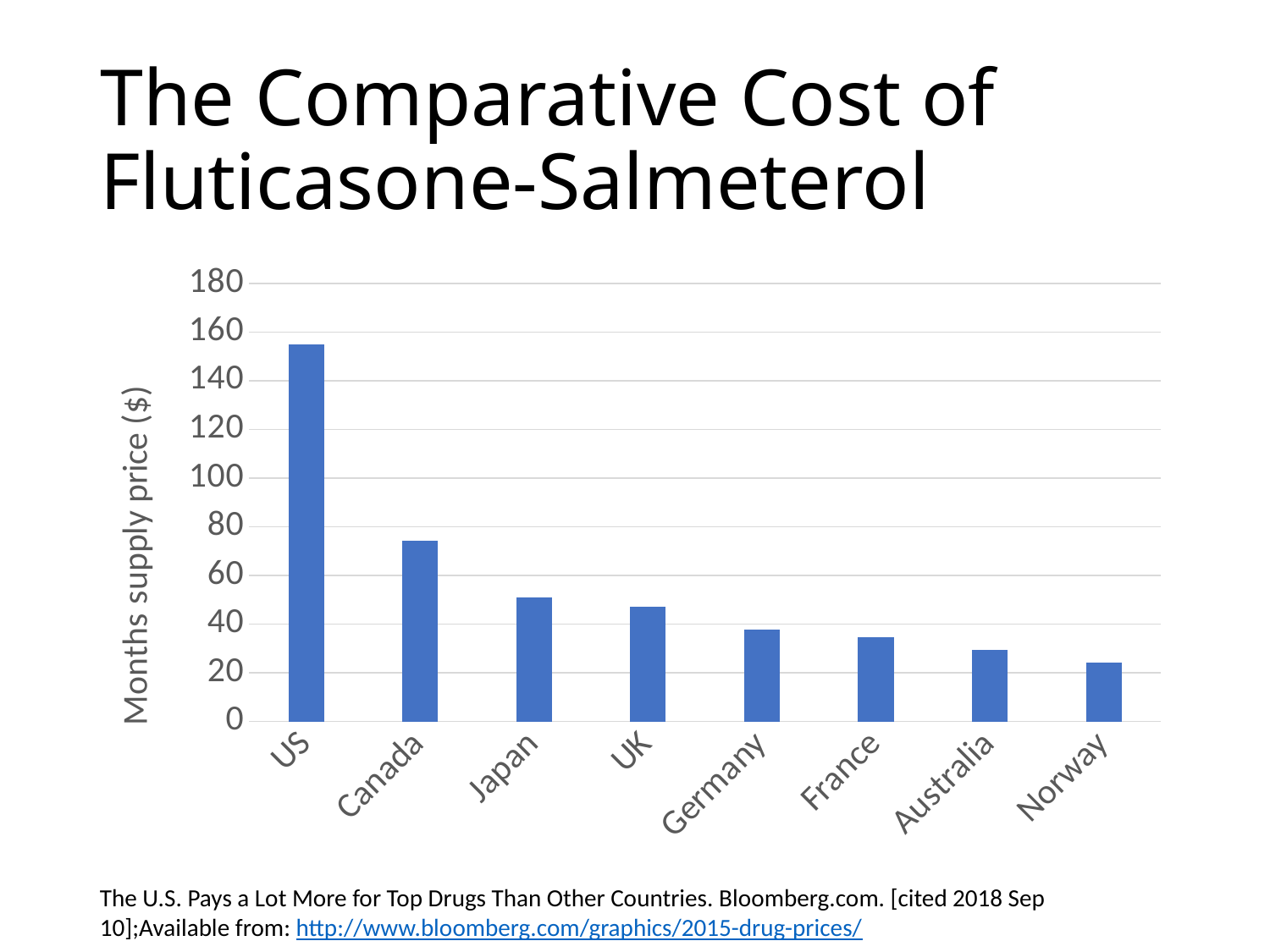
What is the label on the vertical axis of the chart? Months supply price ($) Is the value for US greater or less than 140? greater Which country has the highest months supply price? US Is the value for UK greater or less than 60? less Is the value for Norway greater or less than 40? less Which has a higher months supply price, Canada or Japan? Canada How many countries are shown on the x axis of the chart? 8 Do the values rise or fall moving from left to right along the x axis? fall Which country has the lowest months supply price? Norway What kind of chart is shown on the slide? bar chart